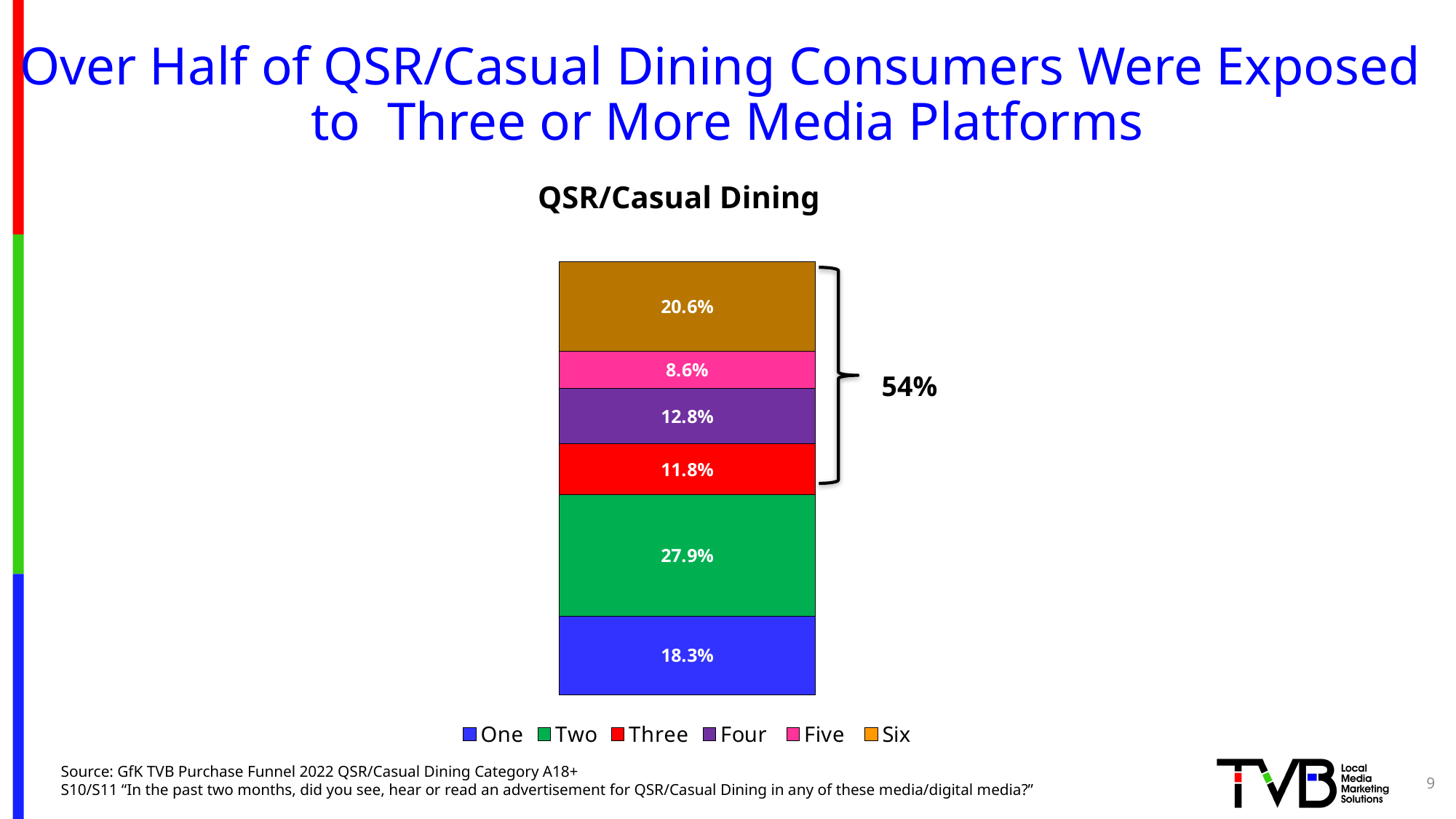
What is the value for the "Six" segment? 20.6% What kind of chart is shown on the slide? stacked bar chart What is the title of the chart? QSR/Casual Dining Which is larger, the "Four" segment or the "Three" segment? Four What is the value for the "Two" segment? 27.9% Which segment has the lowest value? Five What colour is the "Three" segment? red What is the value for the "Five" segment? 8.6% Which segment has the highest value? Two What is the difference between the "Two" and "One" segments? 9.6% What is the combined total of the "Three", "Four", "Five" and "Six" segments, as labelled by the bracket? 54% How many series does the legend list? 6